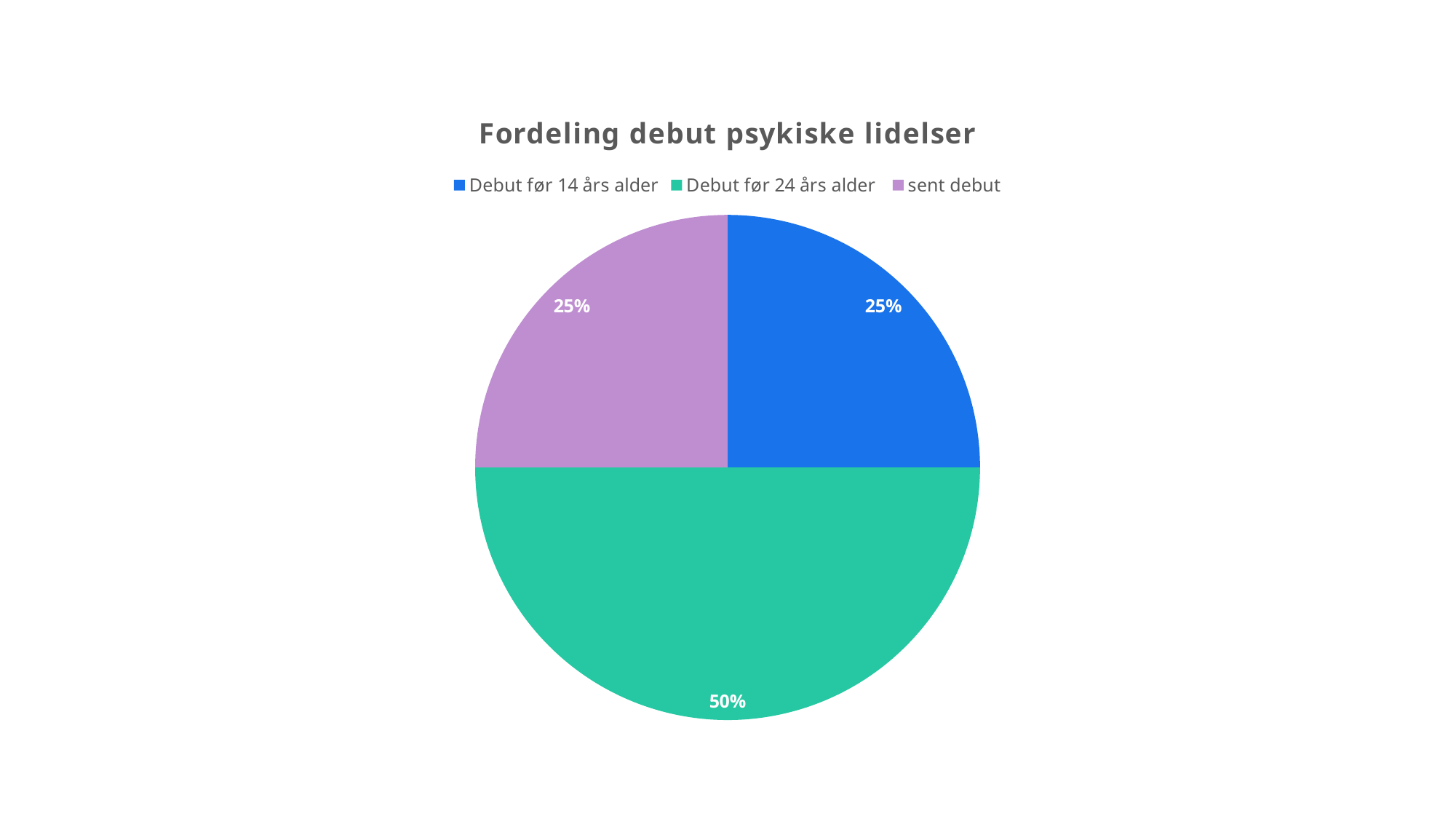
What share of the pie is 'sent debut'? 25% What share of the pie is 'Debut før 24 års alder'? 50% Which category has the largest slice? Debut før 24 års alder How many slices does the pie chart have? 3 How many entries does the legend list? 3 What is the combined share of 'Debut før 14 års alder' and 'sent debut'? 50% What is the difference between the share for 'Debut før 24 års alder' and the share for 'sent debut'? 25% Which is larger, the slice for 'Debut før 24 års alder' or the slice for 'Debut før 14 års alder'? Debut før 24 års alder What colour is the slice for 'sent debut'? purple What is the title of the chart? Fordeling debut psykiske lidelser What kind of chart is shown on the slide? pie chart What share of the pie is 'Debut før 14 års alder'? 25%